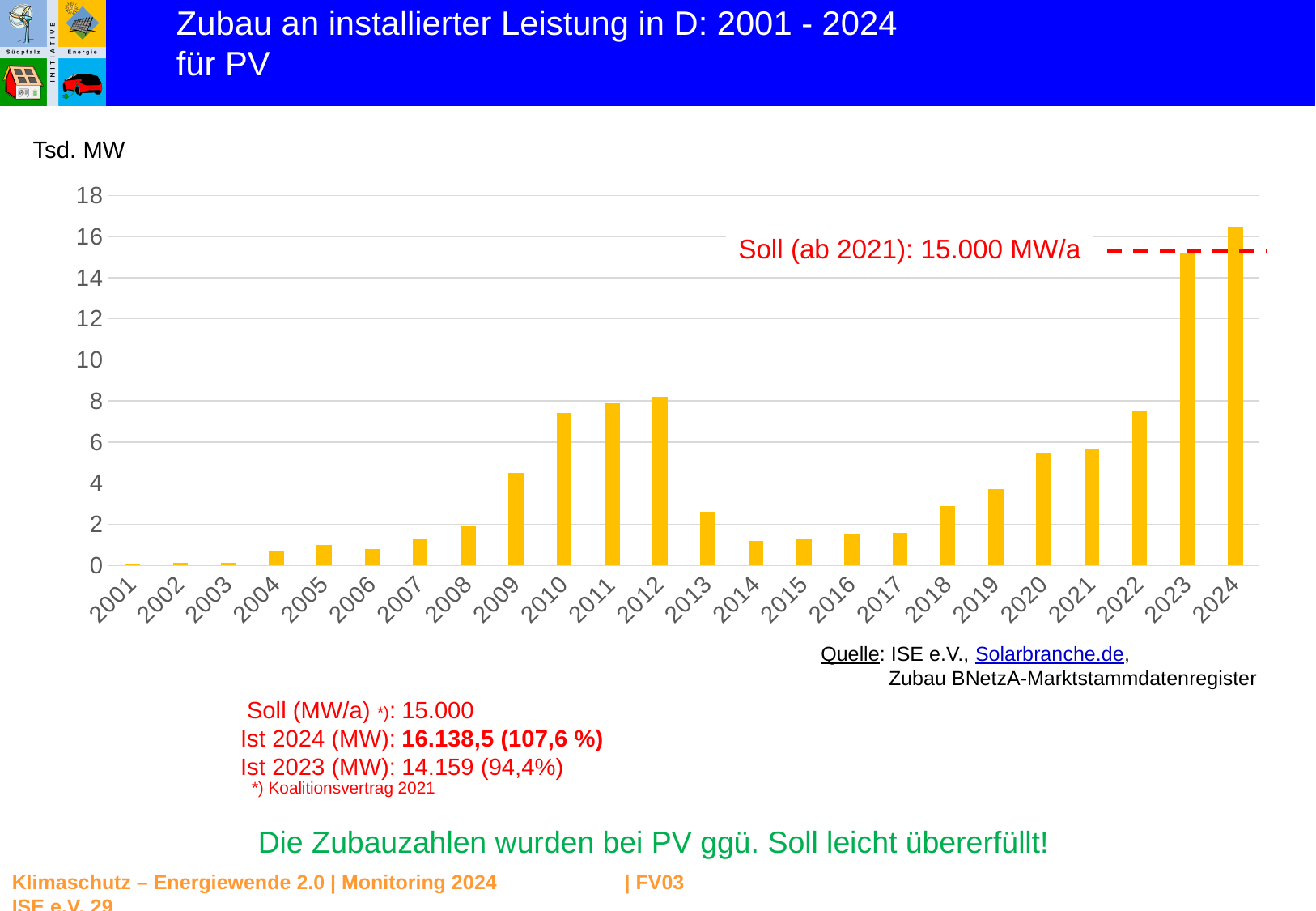
How many years are shown on the x axis of the chart? 24 Do the bars rise or fall from 2009 to 2012? rise Is the value for 2013 greater or less than 4? less Which year has the larger bar, 2010 or 2020? 2010 What unit is given for the y axis of the chart? Tsd. MW What target value (Soll ab 2021) does the dashed red line in the chart represent? 15.000 MW/a What kind of chart is shown on the slide? bar chart Is the value for 2017 greater or less than 2? less Which year has the larger bar, 2018 or 2019? 2019 Which year has the highest bar in the chart? 2024 Is the value for 2010 greater or less than 6? greater